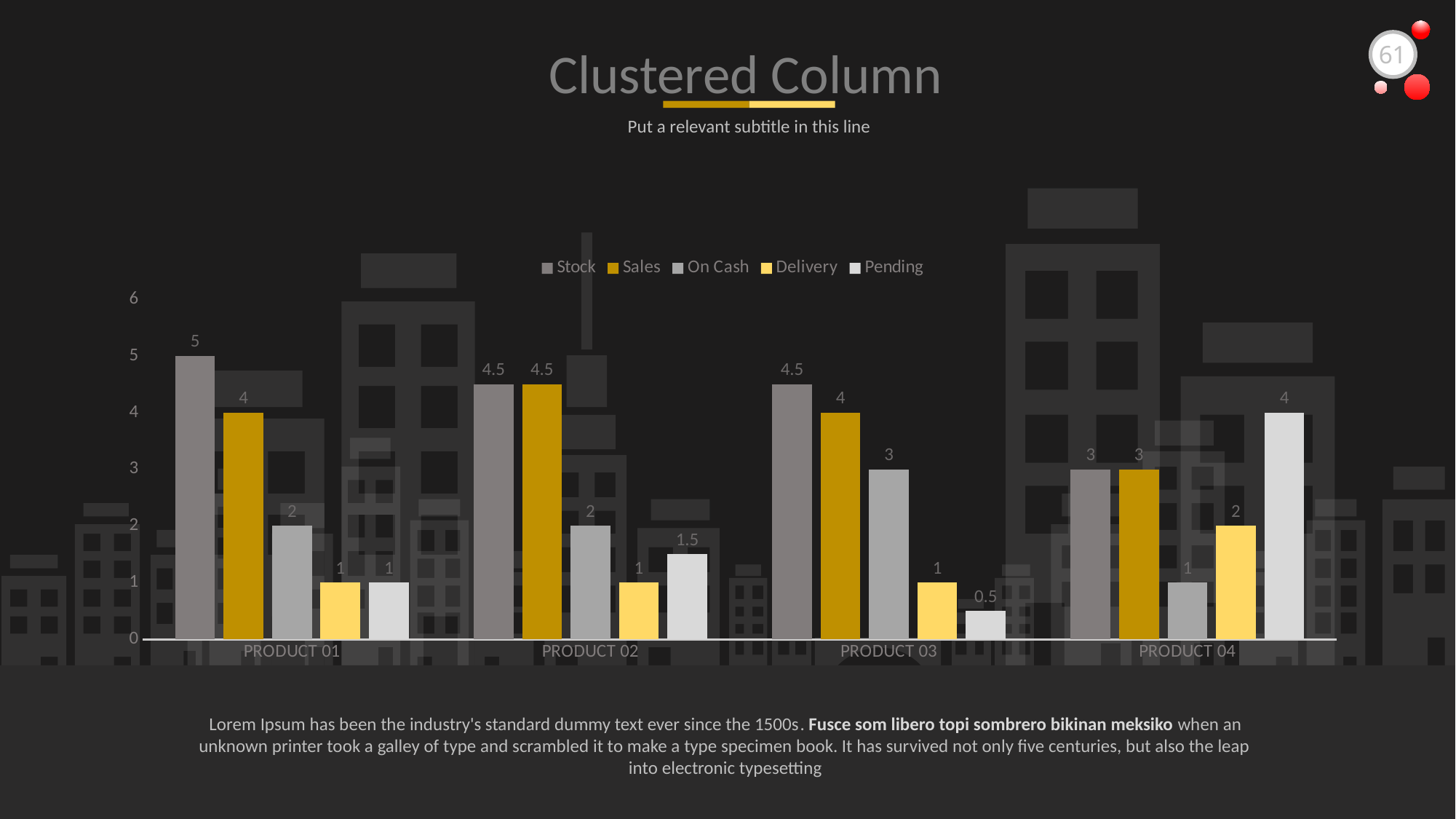
What is the On Cash value for PRODUCT 03? 3 What kind of chart is shown on the slide? Bar chart How many product categories are shown on the x axis? 4 What is the Pending value for PRODUCT 02? 1.5 Which series is shown in dark gold? Sales What is the Delivery value for PRODUCT 04? 2 Which product has the highest Stock value? PRODUCT 01 How many series does the legend list? 5 Which is larger for PRODUCT 04: the Pending value or the Stock value? Pending What is the difference between the Stock and On Cash values for PRODUCT 01? 3 What is the Stock value for PRODUCT 01? 5 Which product has the lowest Pending value? PRODUCT 03